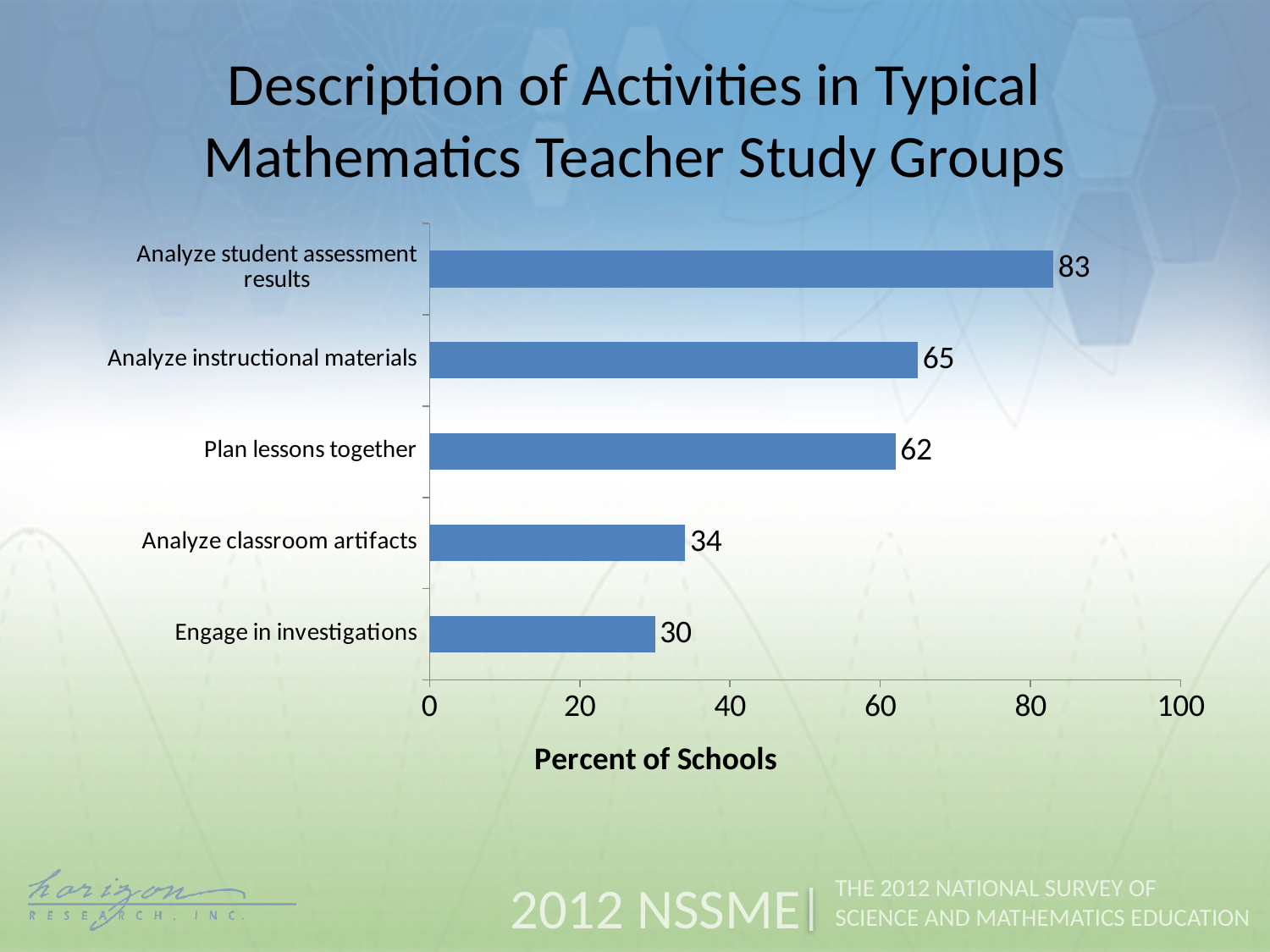
What is the value for 'Plan lessons together'? 62 What is the difference between the values for 'Analyze instructional materials' and 'Analyze classroom artifacts'? 31 How many activities are shown in the chart? 5 What is the value for 'Engage in investigations'? 30 Which activity has the highest percent of schools? Analyze student assessment results What percent of schools report that teacher study groups analyze student assessment results? 83 Is the value for 'Analyze instructional materials' greater or less than 60? greater Which is larger: the value for 'Analyze classroom artifacts' or the value for 'Engage in investigations'? Analyze classroom artifacts What is the difference between the highest and lowest values in the chart? 53 Which activity has the lowest percent of schools? Engage in investigations What kind of chart is shown on the slide? Bar chart What is the label of the horizontal axis? Percent of Schools